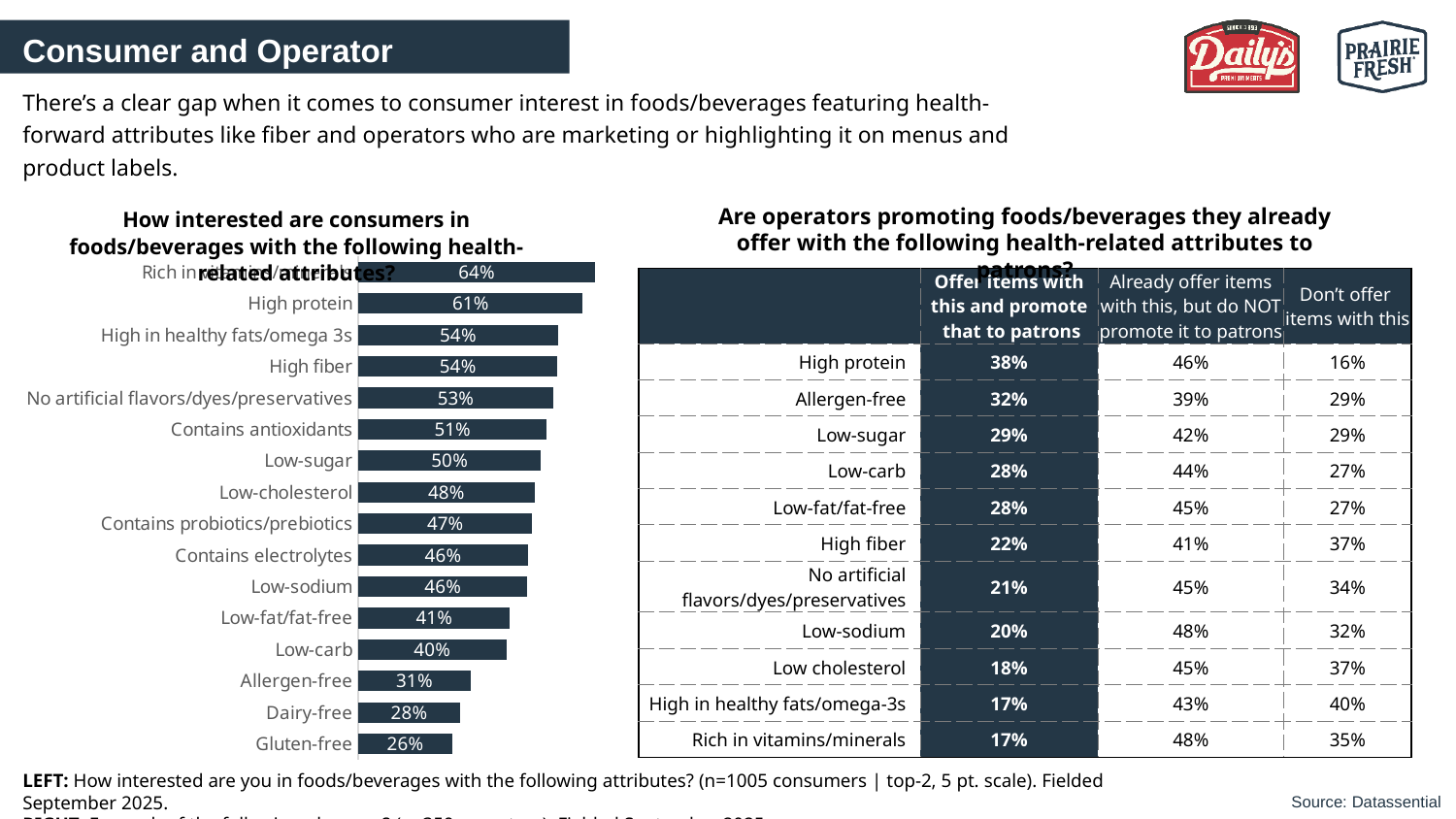
In the bar chart on the left, what is the difference between the values for High protein and Gluten-free? 35 percentage points In the bar chart on the left, do the values increase or decrease from the top bar to the bottom bar? Decrease In the bar chart on the left, what percentage of consumers are interested in foods/beverages that are high in protein? 61% In the bar chart on the left, what is the difference between the values for High fiber and Low-carb? 14 percentage points What type of chart is shown on the left side of the slide? Bar chart In the bar chart on the left, which has a higher value: Low-carb or Low-fat/fat-free? Low-fat/fat-free In the bar chart on the left, what is the value for Dairy-free? 28% How many attributes are shown in the bar chart on the left? 16 In the bar chart on the left, what is the value for Low-sugar? 50% In the bar chart on the left, which attribute has the lowest consumer interest? Gluten-free In the bar chart on the left, what is the value for Allergen-free? 31% In the bar chart on the left, what is the value for No artificial flavors/dyes/preservatives? 53%